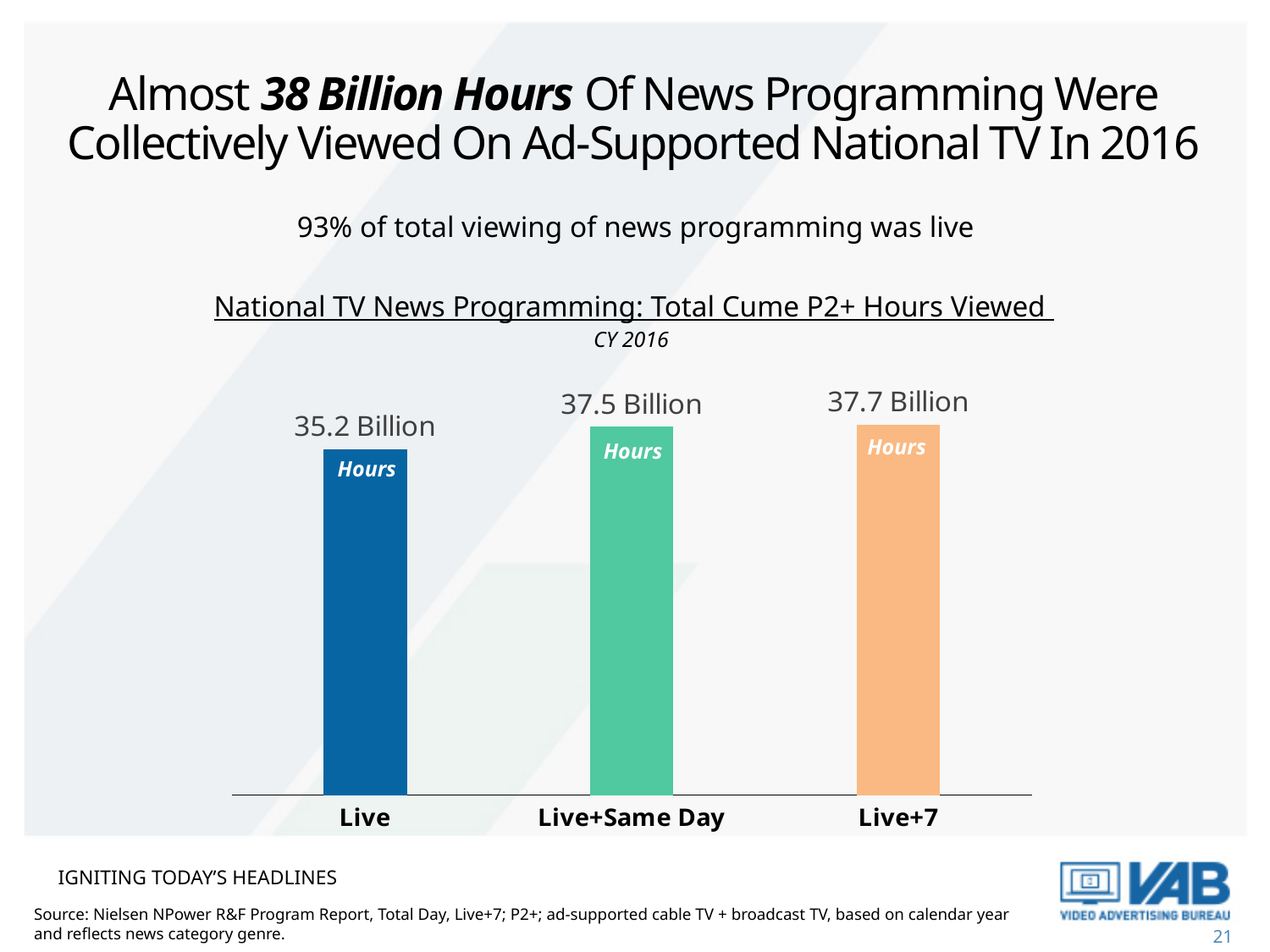
What kind of chart is this? Bar chart What is the value for Live+Same Day? 37.5 Billion Which is larger, the value for Live or the value for Live+Same Day? Live+Same Day What is the title of the chart? National TV News Programming: Total Cume P2+ Hours Viewed What is the difference between the Live+Same Day and Live values? 2.3 Billion How many categories are shown on the x axis? 3 What is the difference between the Live+7 and Live values? 2.5 Billion What is the value for Live? 35.2 Billion What is the value for Live+7? 37.7 Billion Which category has the highest value? Live+7 Do the values rise or fall from left to right along the x axis? Rise Which category has the lowest value? Live